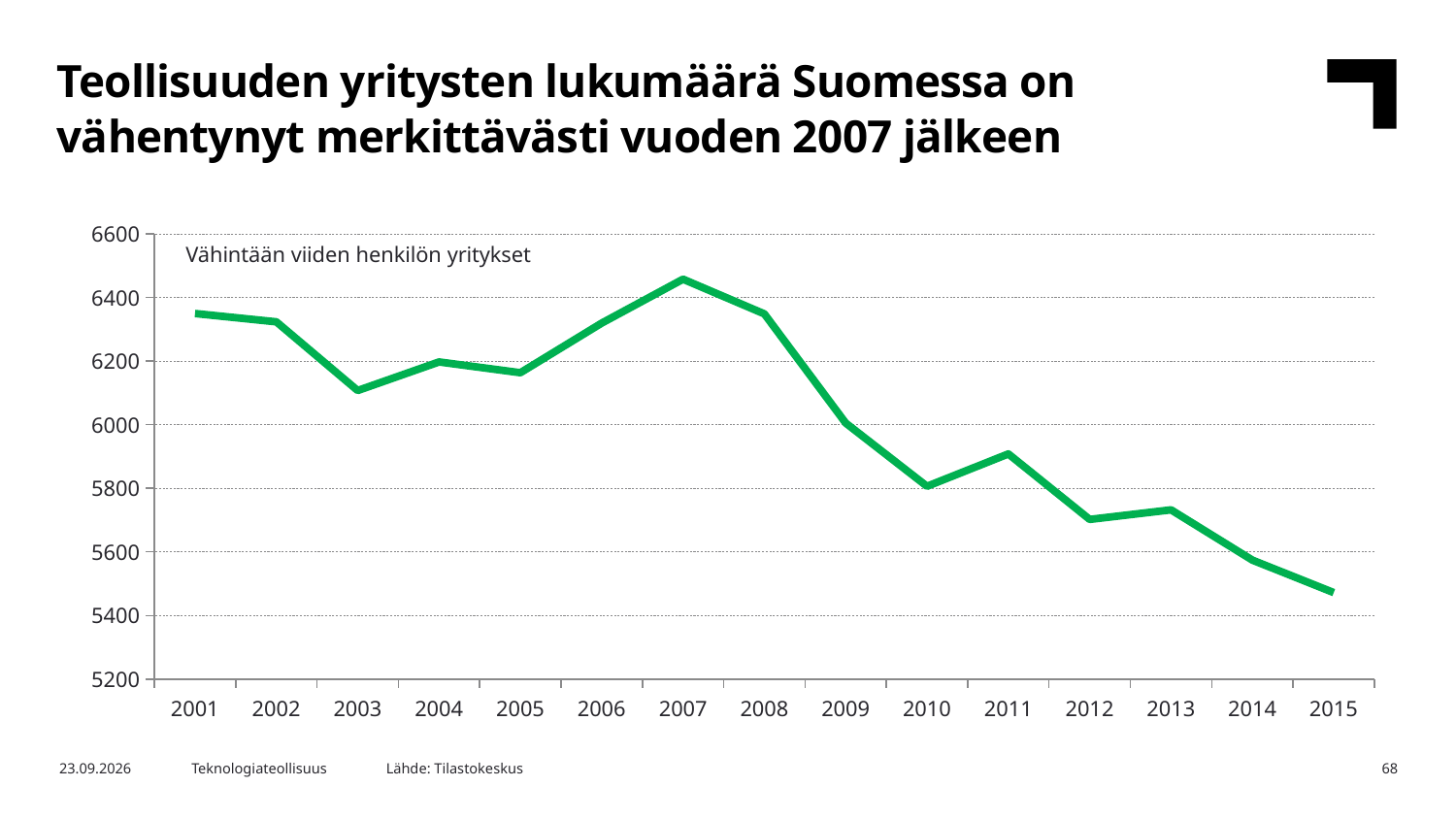
How many years are plotted on the x axis? 15 Does the number of companies rise or fall from 2007 to 2015? fall Is the value for 2011 greater or less than 5800? greater Is the value for 2003 greater or less than 6000? greater What text label is shown inside the plot area describing the companies included? Vähintään viiden henkilön yritykset Is the value for 2007 greater or less than 6400? greater What kind of chart is shown on the slide? line chart In which year is the number of companies lowest? 2015 Which year has the larger value, 2003 or 2011? 2003 In which year is the number of companies highest? 2007